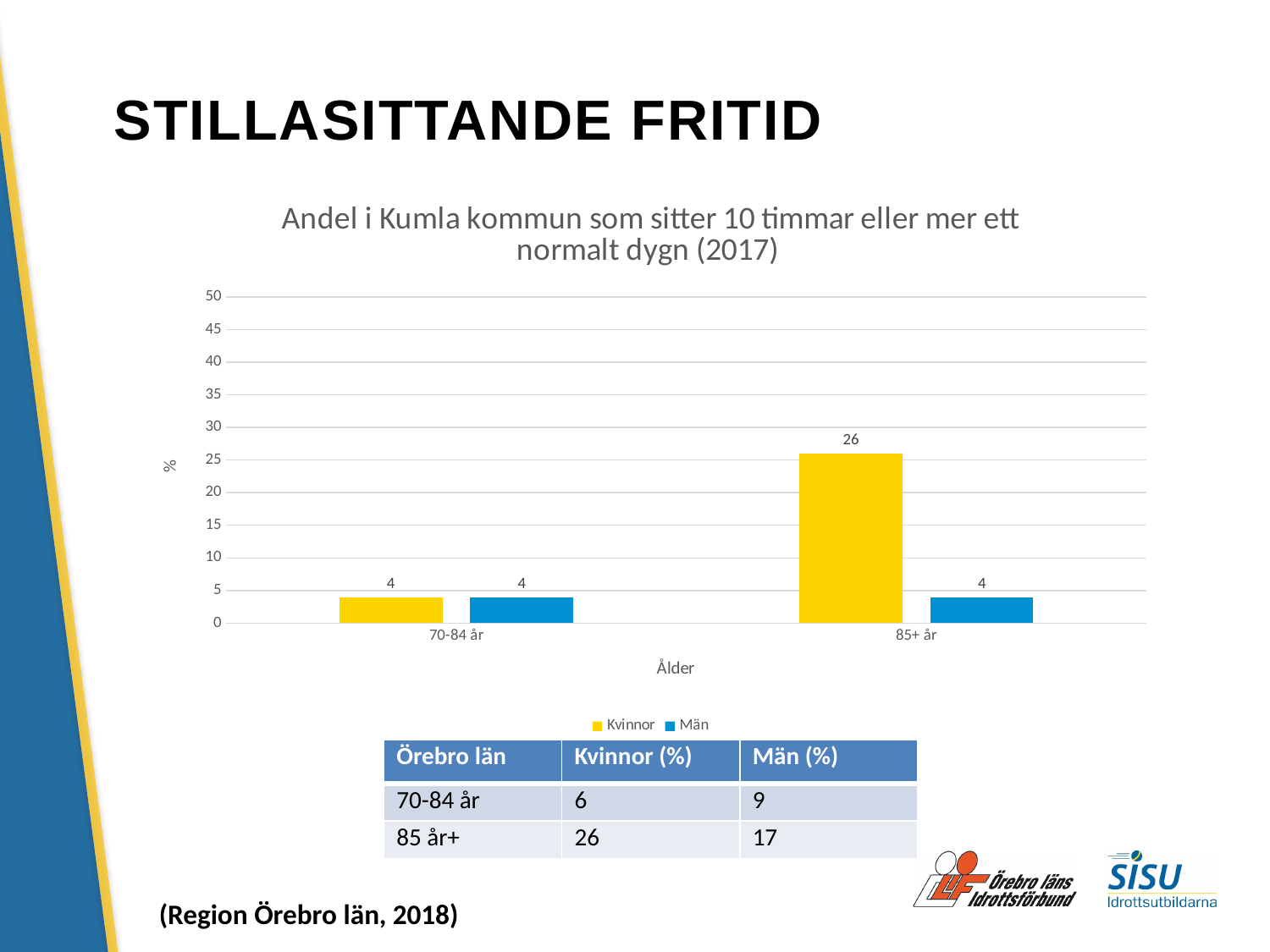
Is the value for Kvinnor in the 85+ år category greater or less than 20? greater What kind of chart is shown on the slide? bar chart In the 85+ år category, which series has the larger value, Kvinnor or Män? Kvinnor How many age categories are shown on the x axis? 2 How many series does the legend list? 2 What is the value for Kvinnor in the 85+ år category? 26 Which age category has the highest value for Kvinnor? 85+ år What is the value for Män in the 85+ år category? 4 What is the difference between the Kvinnor and Män values in the 85+ år category? 22 What is the value for Kvinnor in the 70-84 år category? 4 What is the label of the x axis? Ålder What is the value for Män in the 70-84 år category? 4